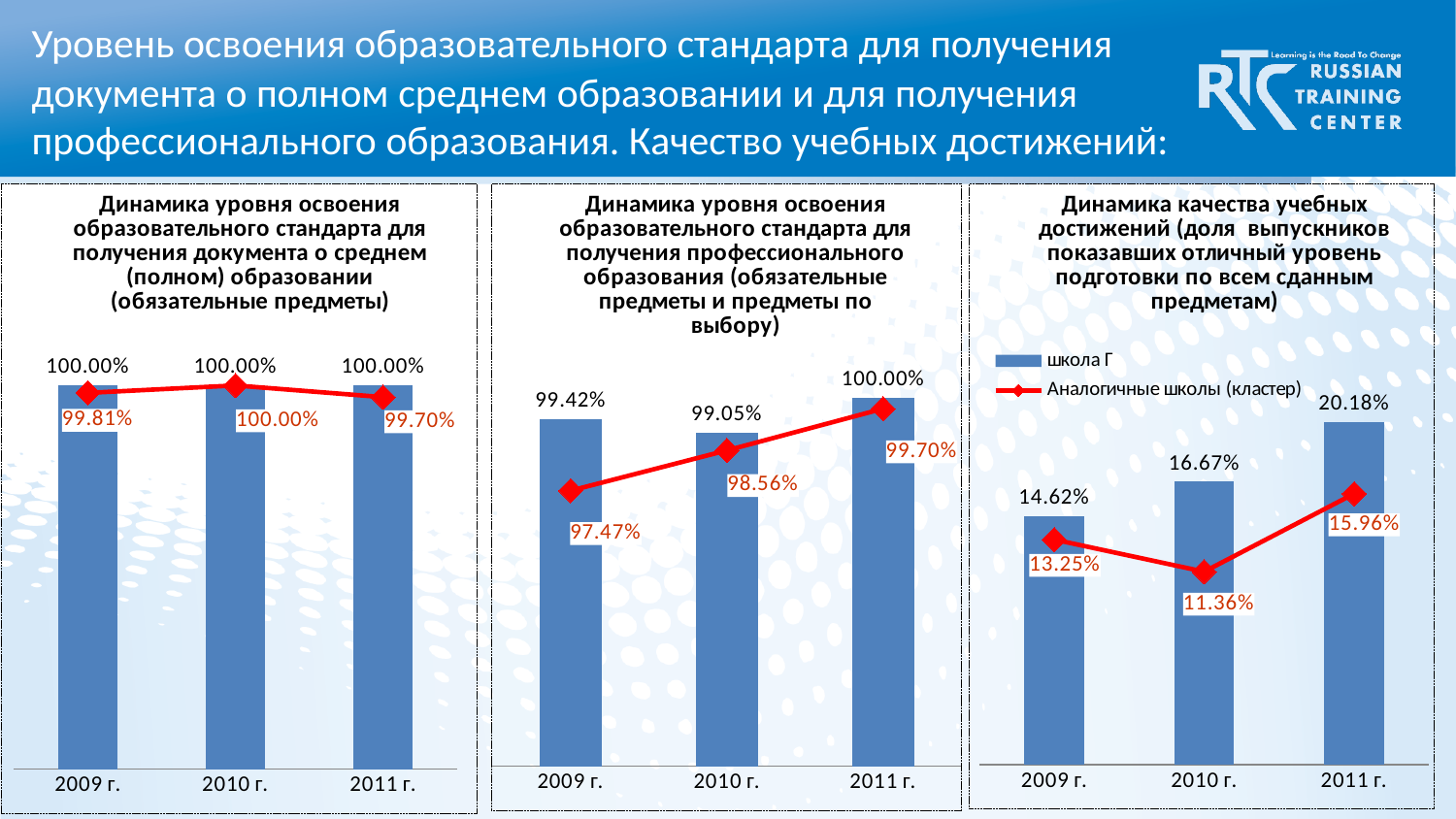
On the middle chart (Динамика уровня освоения образовательного стандарта для получения профессионального образования), what is the line value for 2009 г.? 97.47% On the middle chart (Динамика уровня освоения образовательного стандарта для получения профессионального образования), does the line series rise or fall from 2009 г. to 2011 г.? rise On the right chart (Динамика качества учебных достижений), in which year is the value for школа Г the highest? 2011 г. On the right chart (Динамика качества учебных достижений), how many series does the legend list? 2 On the middle chart (Динамика уровня освоения образовательного стандарта для получения профессионального образования), which is larger in 2010 г., the bar value or the line value? the bar value (99.05%) On the left chart (Динамика уровня освоения образовательного стандарта для получения документа о среднем (полном) образовании), what is the line value for 2011 г.? 99.70% On the right chart (Динамика качества учебных достижений), what is the difference between школа Г and Аналогичные школы (кластер) in 2011 г.? 4.22% On the right chart (Динамика качества учебных достижений), in which year is the value for Аналогичные школы (кластер) the lowest? 2010 г. On the middle chart (Динамика уровня освоения образовательного стандарта для получения профессионального образования), what is the bar value for 2009 г.? 99.42% On the right chart (Динамика качества учебных достижений), what is the value for Аналогичные школы (кластер) in 2010 г.? 11.36% On the left chart (Динамика уровня освоения образовательного стандарта для получения документа о среднем (полном) образовании), how many years are shown on the x axis? 3 On the right chart (Динамика качества учебных достижений), what is the value for школа Г in 2011 г.? 20.18%